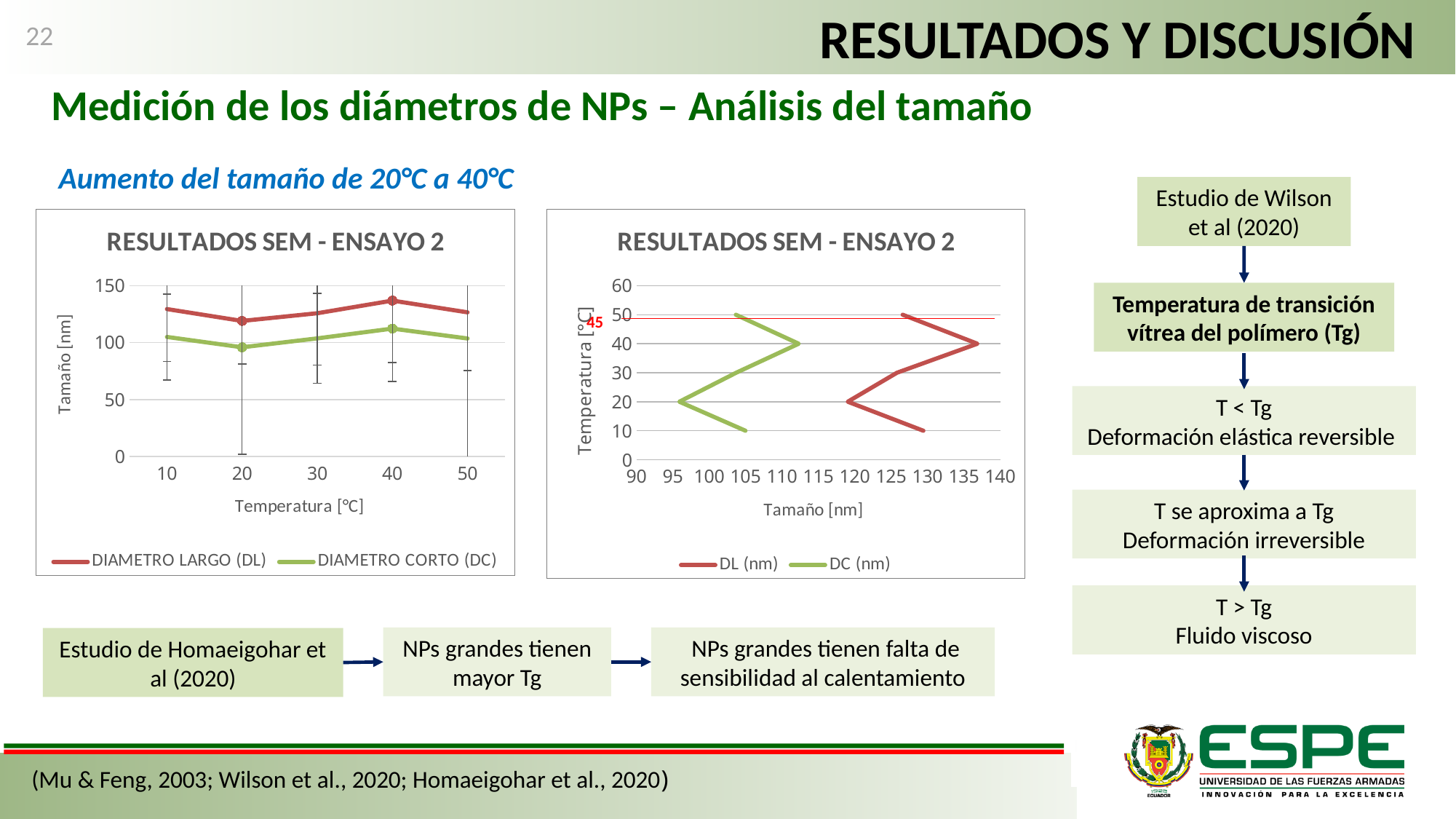
In the left chart, is the value of DIAMETRO LARGO (DL) at 10 °C greater or less than 100? greater What kind of chart is the left chart titled RESULTADOS SEM - ENSAYO 2? line chart In the left chart, does DIAMETRO LARGO (DL) rise or fall from 20 °C to 40 °C? rise In the left chart, is the value of DIAMETRO CORTO (DC) at 40 °C greater or less than 100? greater In the left chart, at which temperature is DIAMETRO CORTO (DC) lowest? 20 What is the label of the x axis of the right chart? Tamaño [nm] In the left chart, how many temperature points are plotted for each series? 5 In the right chart, is the DC (nm) value at 20 °C greater or less than 100? less How many series does the legend of the left chart list? 2 In the left chart, at which temperature is DIAMETRO LARGO (DL) highest? 40 In the left chart, which series has the larger value at 40 °C, DIAMETRO LARGO (DL) or DIAMETRO CORTO (DC)? DIAMETRO LARGO (DL)